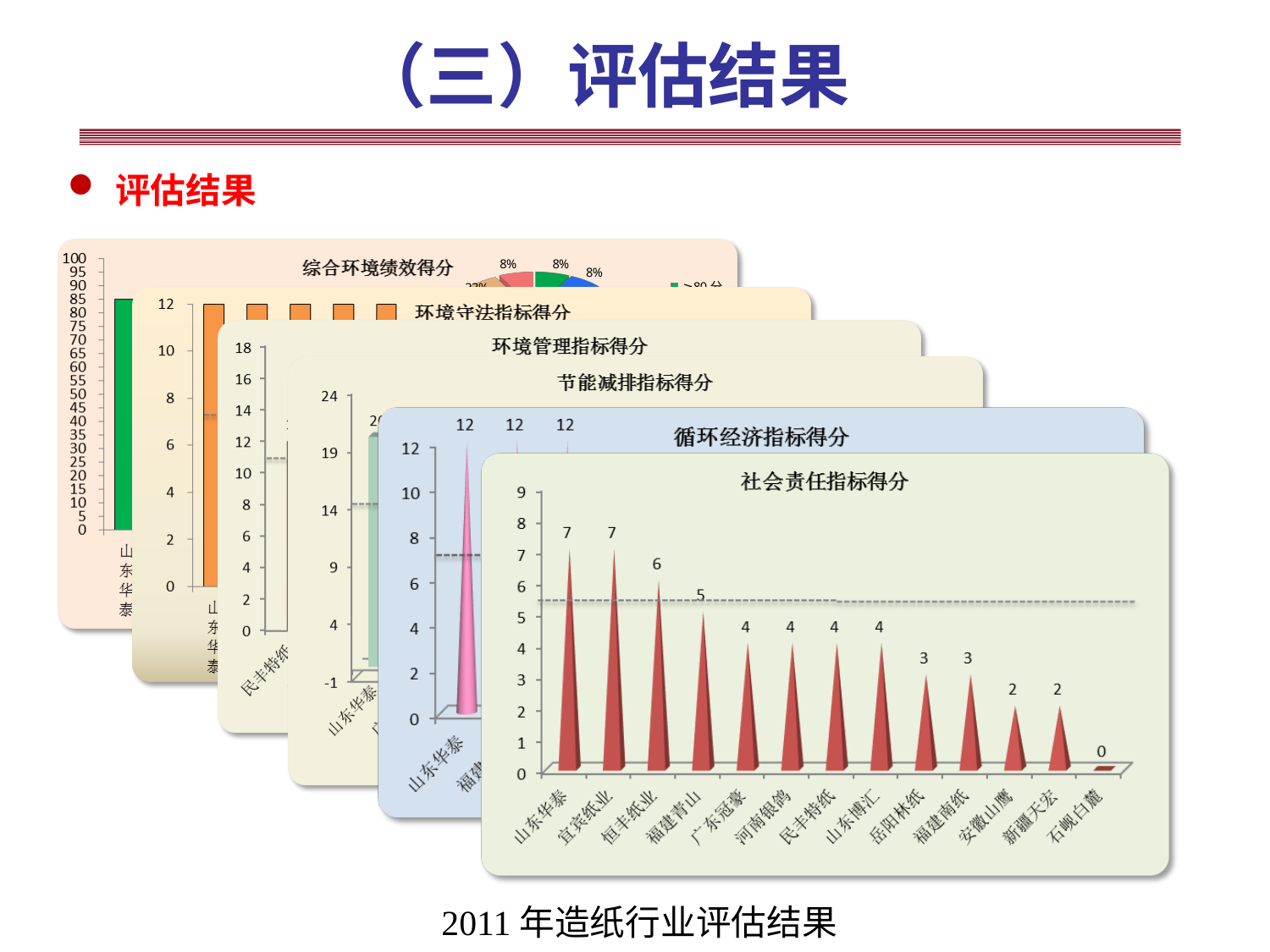
In the 社会责任指标得分 chart, do the values generally rise or fall from left to right along the x axis? fall In the 社会责任指标得分 chart, what is the value for 福建青山? 5 In the 社会责任指标得分 chart, what is the value for 恒丰纸业? 6 What is the title of the chart at the very back (top left) of the stack of charts? 综合环境绩效得分 In the 综合环境绩效得分 chart, is the value for 山东华泰 greater or less than 50? greater What kind of chart is the 社会责任指标得分 chart? bar chart In the 社会责任指标得分 chart, which is larger, the value for 恒丰纸业 or the value for 福建南纸? 恒丰纸业 In the 循环经济指标得分 chart, what is the value for 山东华泰? 12 How many categories are shown on the x axis of the 社会责任指标得分 chart? 13 In the 社会责任指标得分 chart, which category has the lowest value? 石岘白麓 In the 社会责任指标得分 chart, what is the value for 岳阳林纸? 3 In the 社会责任指标得分 chart, what is the difference between the values for 山东华泰 and 新疆天宏? 5